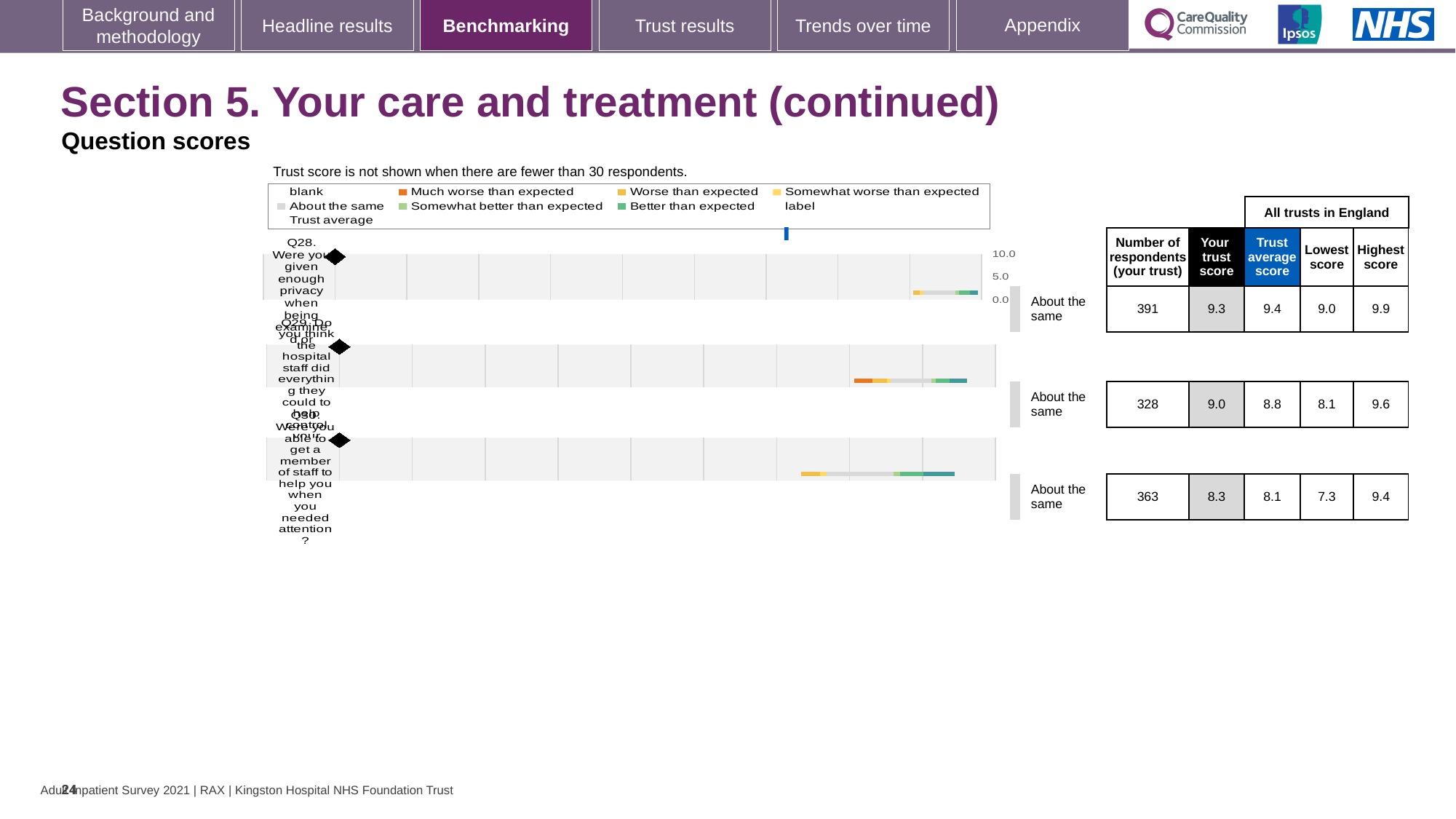
For Q29, which is larger: the trust's own score or the trust average score? Your trust score (9.0) How many questions are plotted on this slide? 3 Which of the three questions shown has the lowest 'Your trust score'? Q30 Is the trust average marker for Q28 greater or less than 5.0 on the axis? greater What is the highest score across all trusts in England for Q30 (Were you able to get a member of staff to help you when you needed attention?)? 9.4 How many respondents from the trust answered Q29 (Do you think the hospital staff did everything they could to help control your pain?)? 328 What is the lowest score across all trusts in England for Q30? 7.3 Which of the three questions shown has the highest 'Your trust score'? Q28 For Q28, what is the difference between the trust average score (9.4) and the trust's own score (9.3)? 0.1 What is the 'Your trust score' for Q28 (Were you given enough privacy when being examined or treated?)? 9.3 What benchmark category is shown for Q29? About the same For Q30, what is the difference between the highest score (9.4) and the lowest score (7.3) across all trusts in England? 2.1